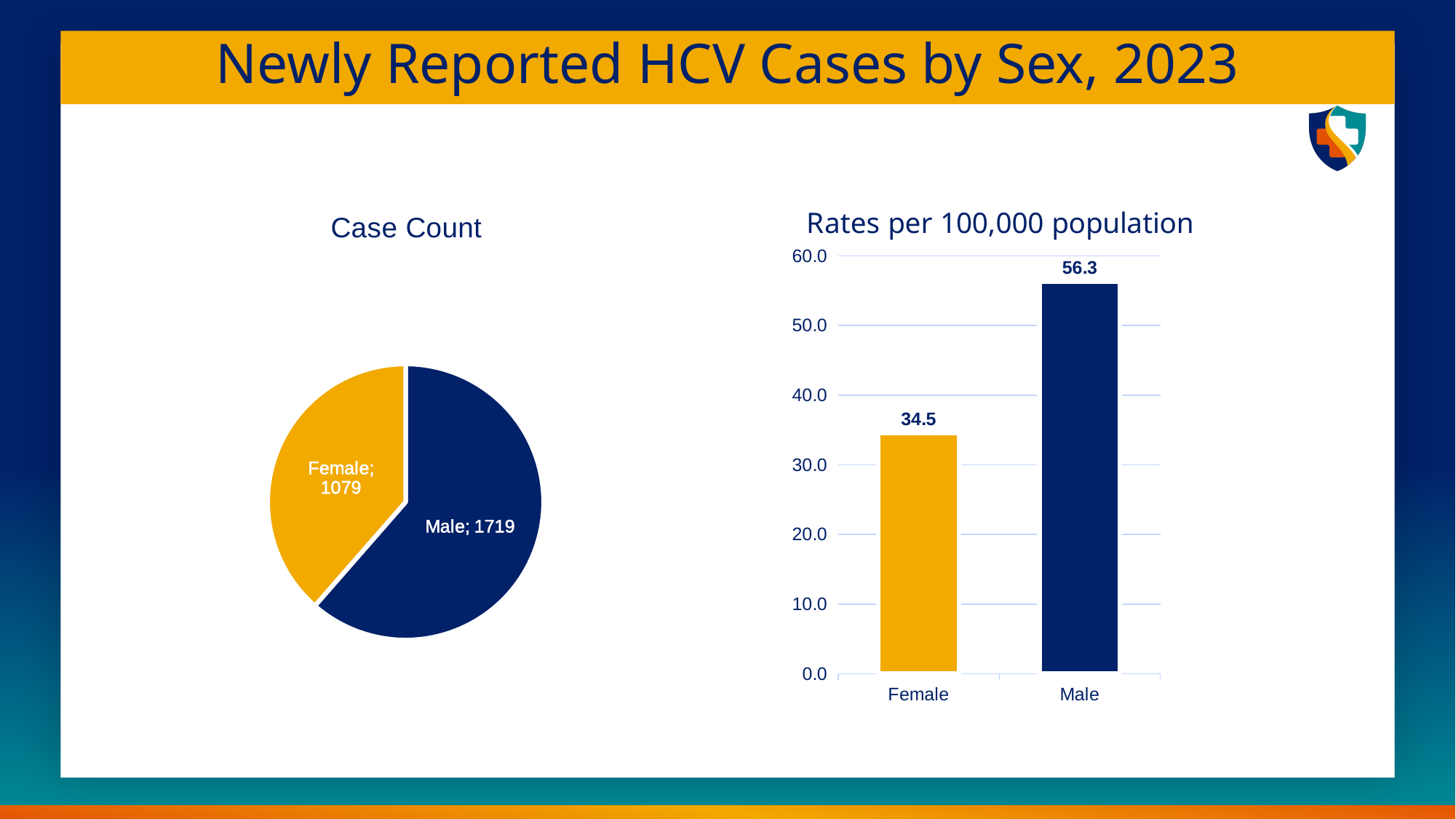
In the Case Count pie chart, what is the total number of cases across both slices? 2798 What kind of chart is the Case Count chart? Pie chart In the Rates per 100,000 population chart, what is the rate for Female? 34.5 In the Case Count pie chart, what is the difference between the Male and Female case counts? 640 In the Case Count pie chart, what share of the total cases does the Male slice represent? 61.4% In the Case Count pie chart, which sex has the larger slice? Male In the Case Count pie chart, how many cases are reported for Female? 1079 In the Rates per 100,000 population chart, what is the rate for Male? 56.3 What kind of chart is the Rates per 100,000 population chart? Bar chart In the Case Count pie chart, how many cases are reported for Male? 1719 In the Rates per 100,000 population chart, is the rate for Male greater or less than 50.0? greater In the Rates per 100,000 population chart, what is the difference between the Male and Female rates? 21.8